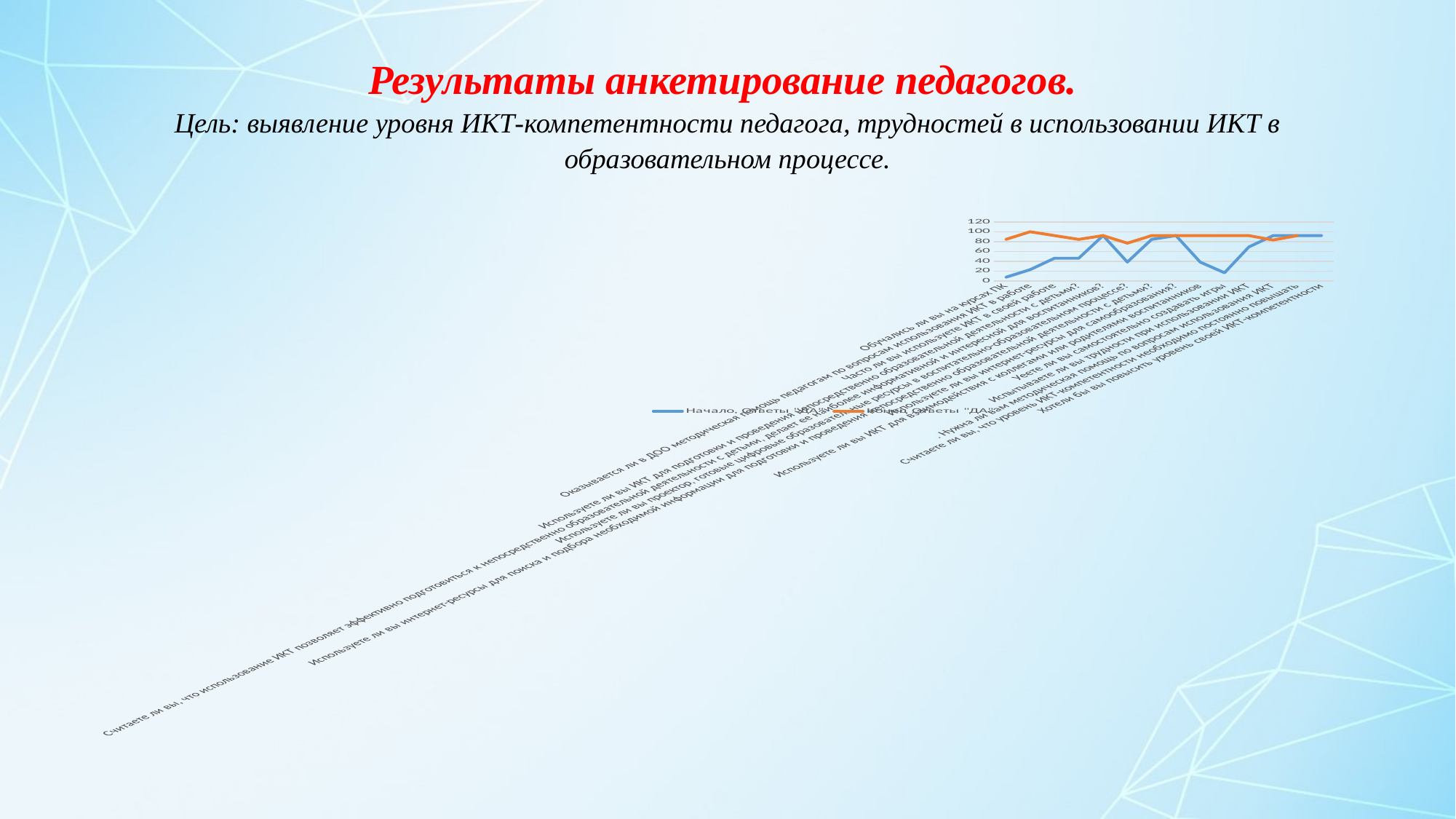
Does the blue series overall rise or fall from the first category to the last category? rise How many series does the chart's legend list? 2 What is the highest value shown on the chart's vertical axis? 120 Is the blue series value for "Обучались ли вы на курсах ПК" greater or less than 40? less What kind of chart is shown on the slide? line chart Which series is drawn in blue on the chart? Начало, Ответы "ДА" Is the orange series value for "Обучались ли вы на курсах ПК" greater or less than 60? greater Is the blue series value for "Хотели бы вы повысить уровень своей ИКТ-компетентности" greater or less than 60? greater For the first category, "Обучались ли вы на курсах ПК", which series has the larger value, the blue one or the orange one? orange